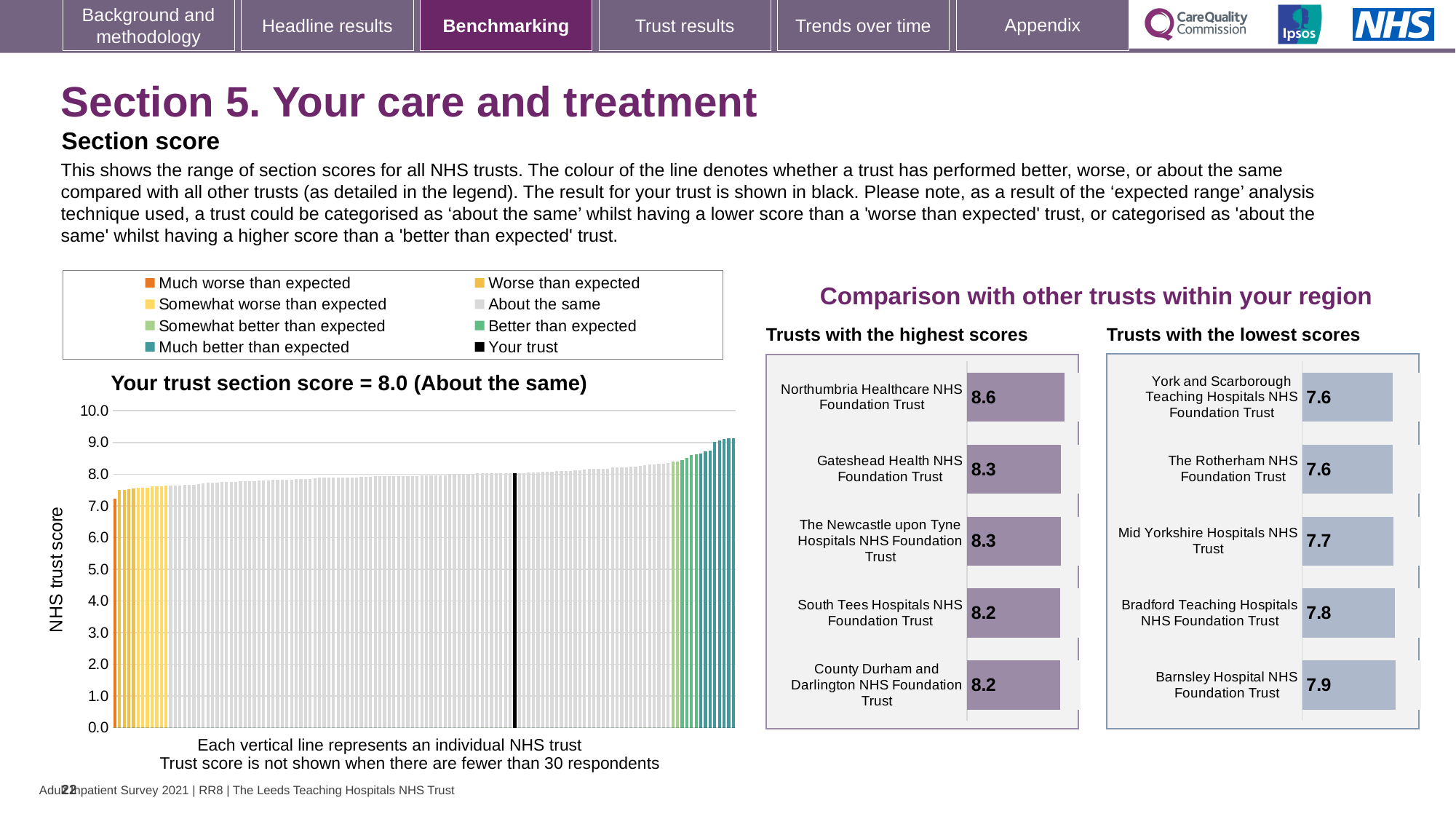
In the 'Trusts with the highest scores' chart, which trust has the highest score? Northumbria Healthcare NHS Foundation Trust In the main chart 'Your trust section score', how many entries does the legend list? 8 In the 'Trusts with the lowest scores' chart, how many trusts are shown? 5 In the main chart 'Your trust section score', what is the label on the vertical axis? NHS trust score In the main chart 'Your trust section score', what is the section score for your trust? 8.0 What kind of chart is the main chart 'Your trust section score'? bar chart In the main chart 'Your trust section score', do the bars rise or fall from left to right? rise In the 'Trusts with the highest scores' chart, what is the difference between the scores of Northumbria Healthcare NHS Foundation Trust and South Tees Hospitals NHS Foundation Trust? 0.4 In the 'Trusts with the lowest scores' chart, what is the score for Mid Yorkshire Hospitals NHS Trust? 7.7 In the 'Trusts with the highest scores' chart, what is the score for Northumbria Healthcare NHS Foundation Trust? 8.6 In the main chart 'Your trust section score', is the value of the leftmost bar greater or less than 8.0? less In the 'Trusts with the lowest scores' chart, which has the larger score, Bradford Teaching Hospitals NHS Foundation Trust or Mid Yorkshire Hospitals NHS Trust? Bradford Teaching Hospitals NHS Foundation Trust